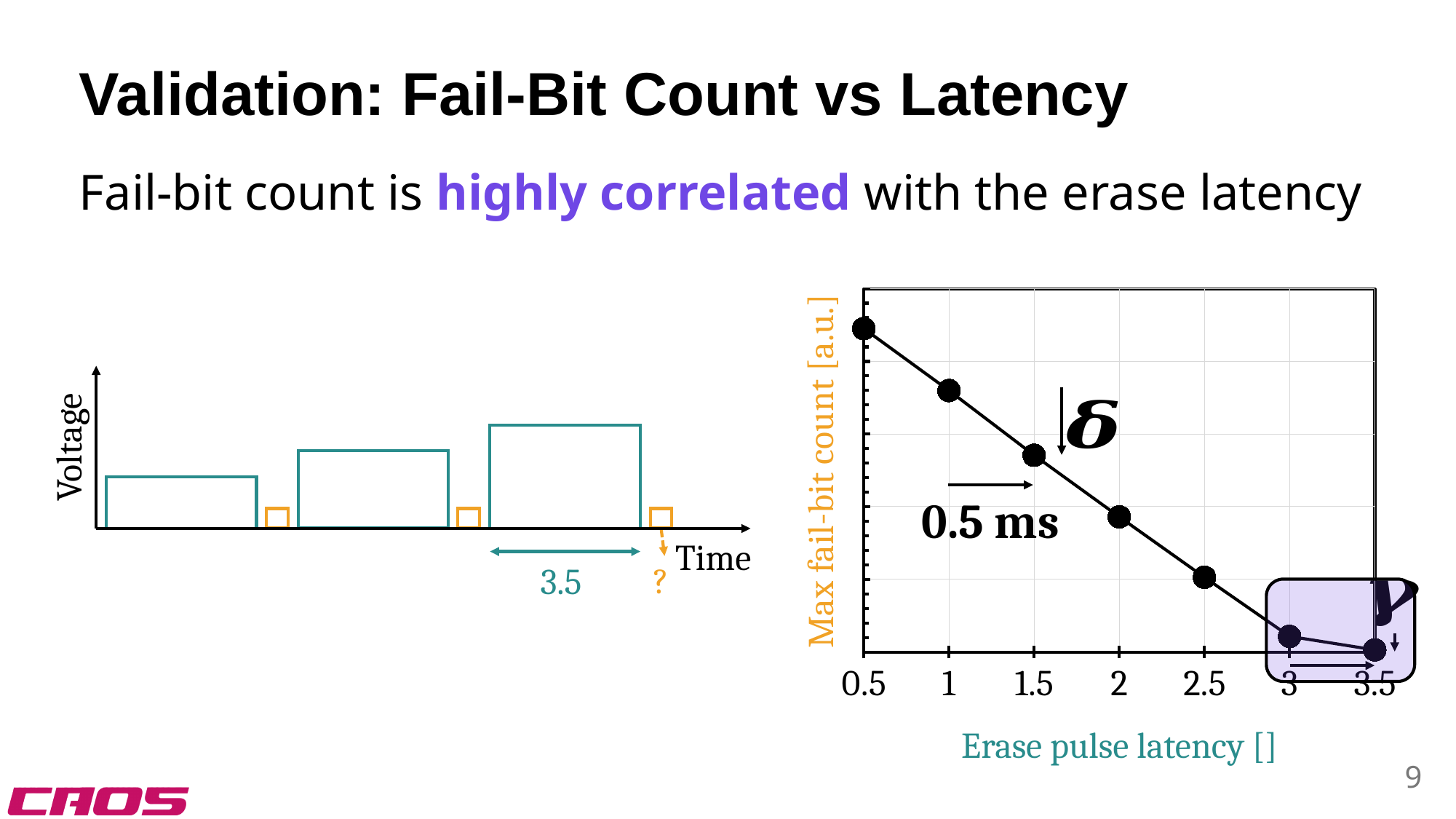
At which erase pulse latency is the max fail-bit count highest? 0.5 How many data points are plotted on the fail-bit count chart? 7 What kind of chart is shown on the right of the slide? line chart What is the smallest erase pulse latency tick shown on the x axis of the chart? 0.5 Which has a higher max fail-bit count: erase pulse latency 1 or 2.5? 1 Which has a higher max fail-bit count: erase pulse latency 3 or 1.5? 1.5 What is the label of the x axis on the fail-bit count chart? Erase pulse latency [] What is the largest erase pulse latency tick shown on the x axis of the chart? 3.5 At which erase pulse latency is the max fail-bit count lowest? 3.5 What is the label of the y axis on the fail-bit count chart? Max fail-bit count [a.u.] Do the values on the fail-bit count chart rise or fall as erase pulse latency increases? fall